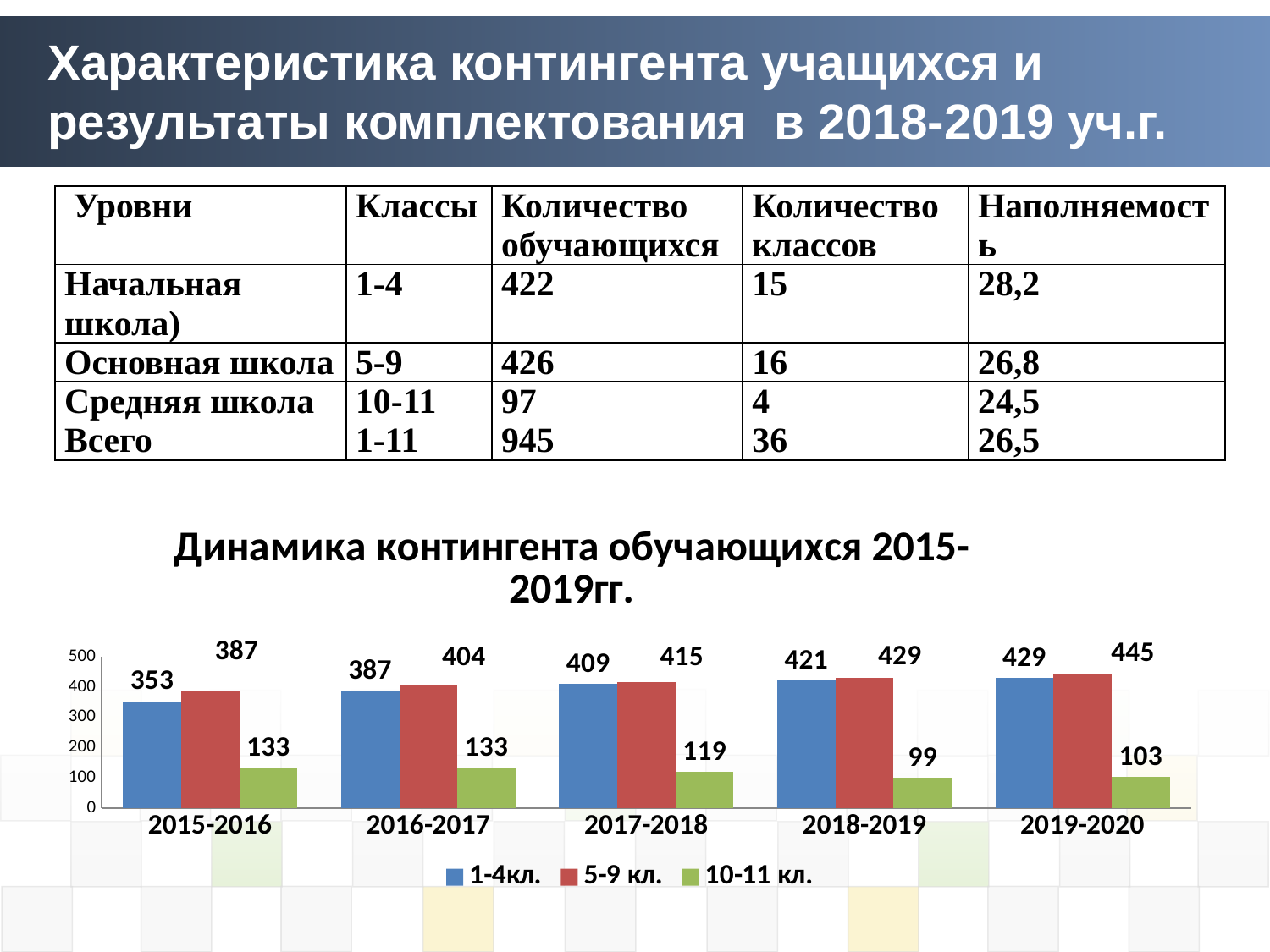
In which school year is the value for 1-4кл. highest? 2019-2020 How many school years are shown on the x axis? 5 What kind of chart is shown on the slide? bar chart Which is larger in 2017-2018: the value for 1-4кл. or for 10-11 кл.? 1-4кл. How many series does the legend list? 3 What is the difference between the 5-9 кл. and 1-4кл. values in 2016-2017? 17 What is the value for 5-9 кл. in 2019-2020? 445 Do the values for 1-4кл. rise or fall from 2015-2016 to 2019-2020? rise What is the value for 10-11 кл. in 2018-2019? 99 Is the value for 5-9 кл. in 2018-2019 greater or less than 400? greater What is the value for 1-4кл. in 2015-2016? 353 In which school year is the value for 10-11 кл. lowest? 2018-2019